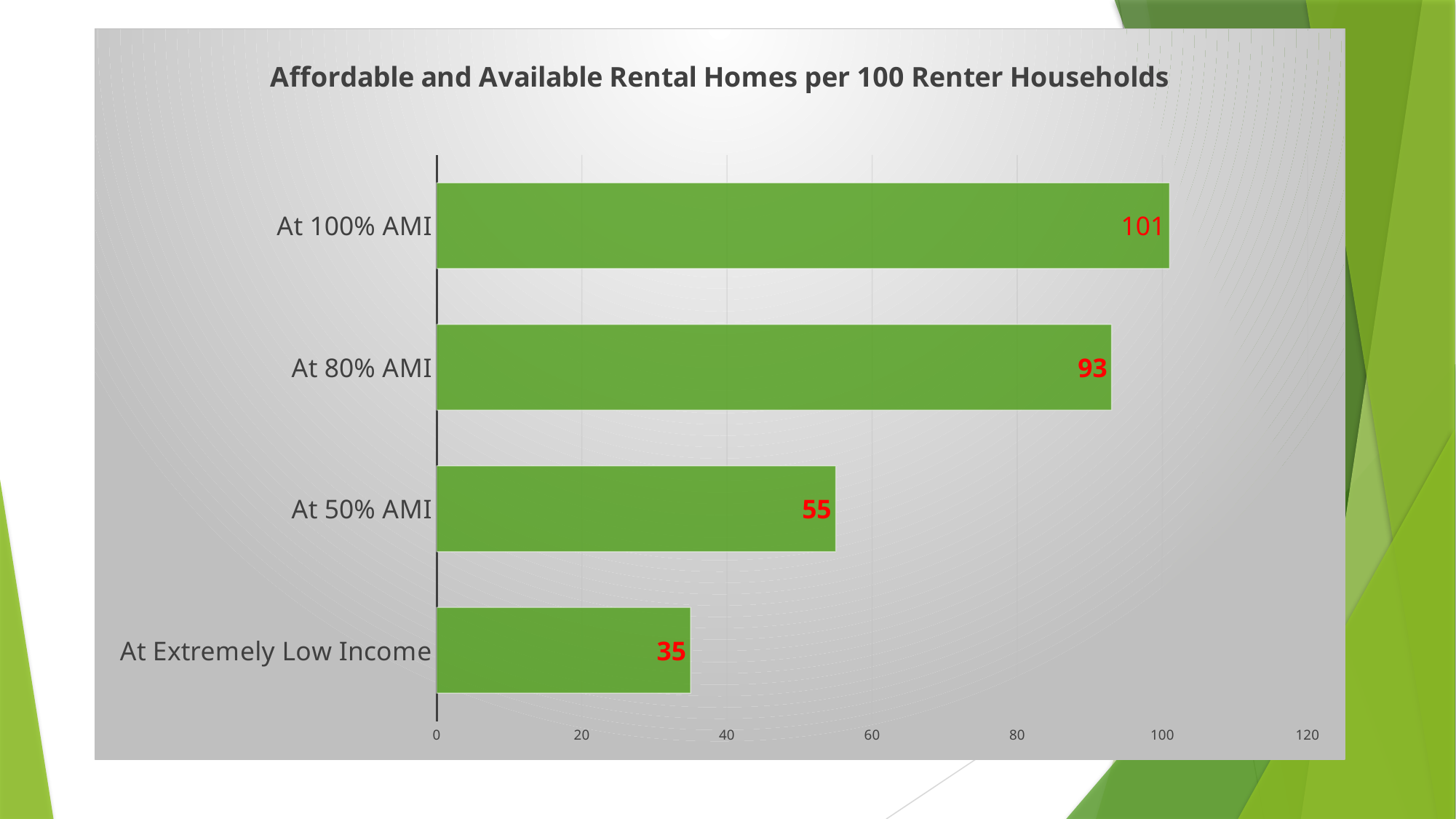
How many categories are shown in the chart? 4 What is the value for At Extremely Low Income? 35 Which is larger, the value for At 50% AMI or the value for At Extremely Low Income? At 50% AMI What is the difference between the values for At 100% AMI and At Extremely Low Income? 66 What kind of chart is shown on the slide? bar chart Is the value for At 80% AMI greater or less than 100? less Which category has the lowest value? At Extremely Low Income What is the value for At 50% AMI? 55 What is the value for At 100% AMI? 101 Which category has the highest value? At 100% AMI What is the difference between the values for At 80% AMI and At 50% AMI? 38 What is the value for At 80% AMI? 93